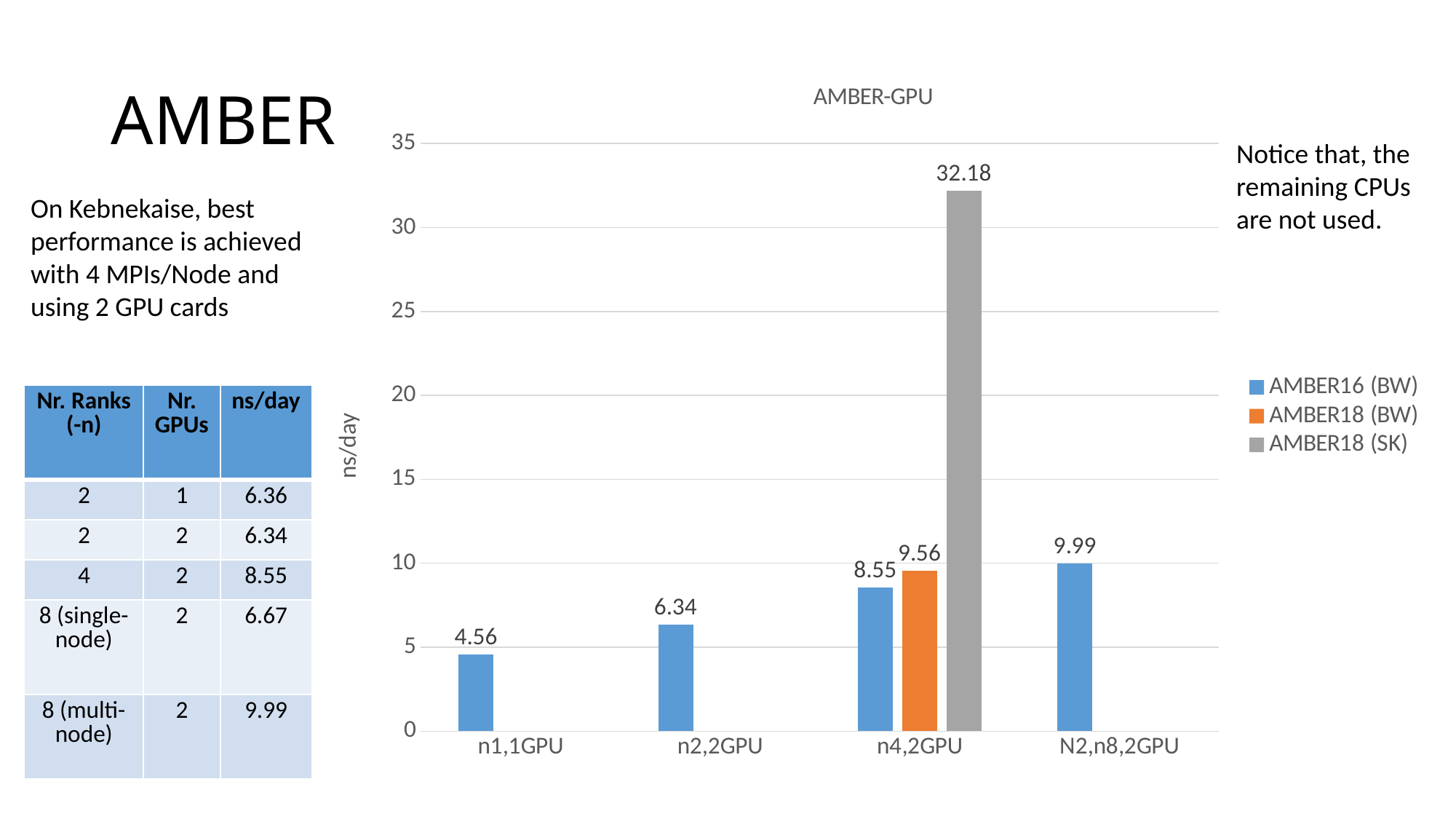
What is the title of the chart? AMBER-GPU Which category has the lowest AMBER16 (BW) value? n1,1GPU What is the value for AMBER18 (SK) at n4,2GPU? 32.18 What is the value for AMBER16 (BW) at n1,1GPU? 4.56 Which is larger at n4,2GPU: AMBER16 (BW) or AMBER18 (BW)? AMBER18 (BW) What is the value for AMBER18 (BW) at n4,2GPU? 9.56 How many series does the legend list? 3 What is the difference between the AMBER18 (SK) and AMBER16 (BW) values at n4,2GPU? 23.63 What kind of chart is shown? bar chart What is the value for AMBER16 (BW) at N2,n8,2GPU? 9.99 Which category has the highest AMBER16 (BW) value? N2,n8,2GPU How many categories are shown on the x axis? 4